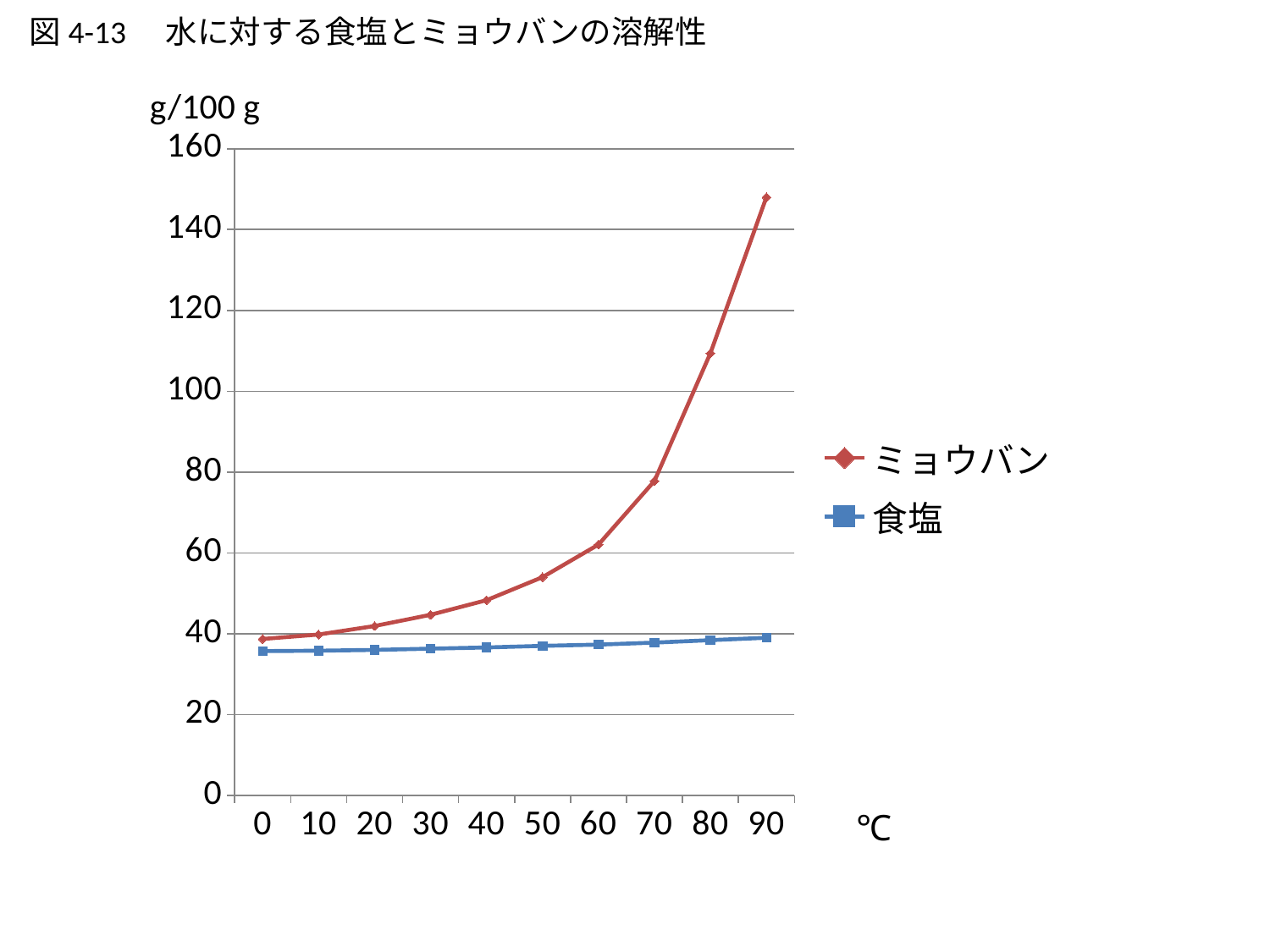
Does the value for ミョウバン rise or fall as temperature increases along the x axis? rise How many series does the legend list? 2 At 90℃, which series has the larger value, ミョウバン or 食塩? ミョウバン Is the value for ミョウバン at 60℃ greater or less than 80? less What unit is shown on the x axis? ℃ What kind of chart is shown on the slide? line chart At which temperature is the value for ミョウバン highest? 90 What unit is shown on the y axis? g/100 g Is the value for 食塩 at 90℃ greater or less than 60? less Is the value for ミョウバン at 80℃ greater or less than 100? greater How many temperature points are plotted along the x axis? 10